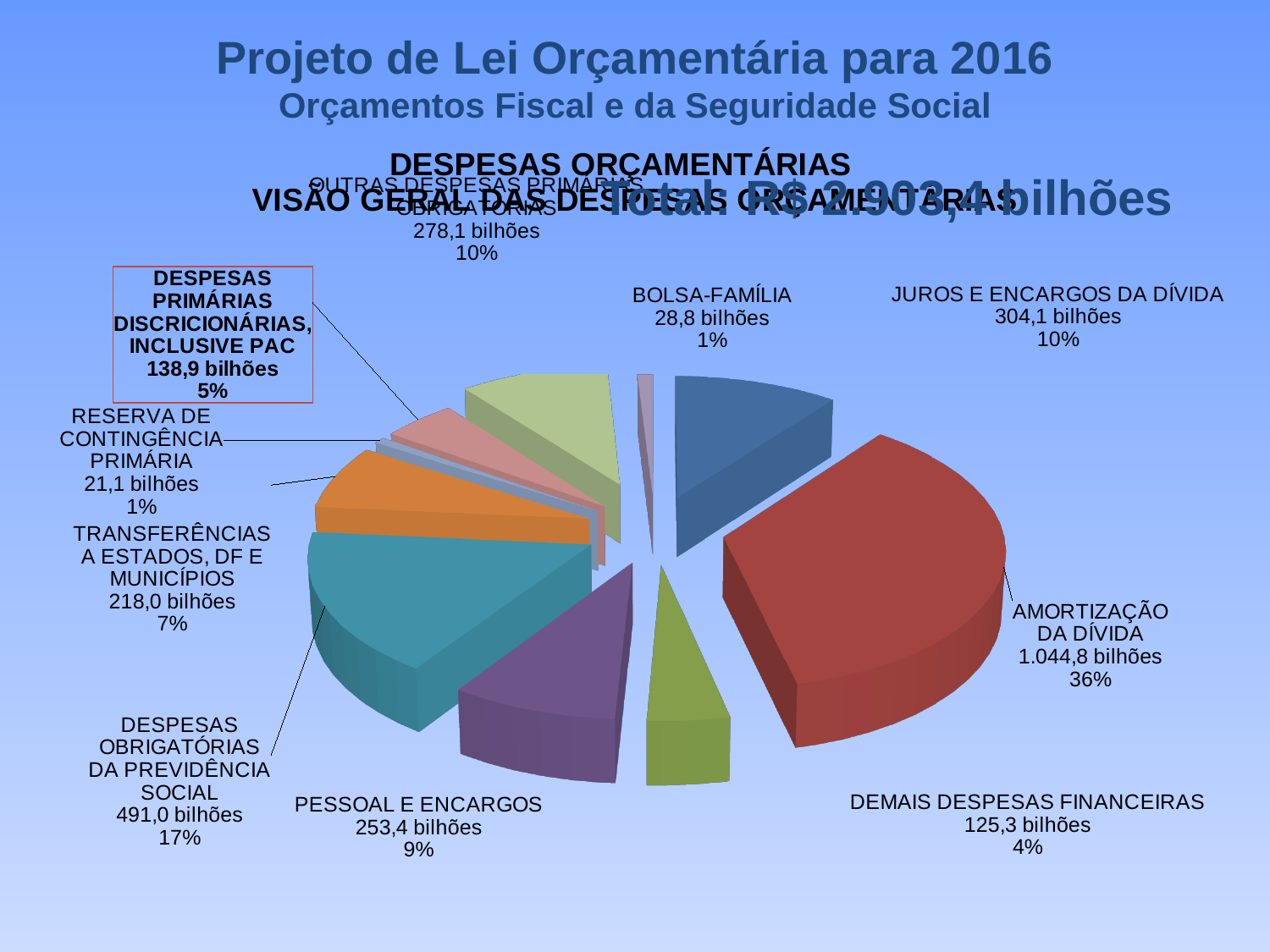
What kind of chart is shown on the slide? pie chart Which category has the largest slice of the pie? AMORTIZAÇÃO DA DÍVIDA How many slices does the pie chart have? 10 What share of the pie does JUROS E ENCARGOS DA DÍVIDA represent? 10% What is the value for AMORTIZAÇÃO DA DÍVIDA? 1.044,8 bilhões What is the main title at the top of the slide? Projeto de Lei Orçamentária para 2016 Which category has the smallest value in the pie? RESERVA DE CONTINGÊNCIA PRIMÁRIA What is the value for PESSOAL E ENCARGOS? 253,4 bilhões What is the value for DESPESAS OBRIGATÓRIAS DA PREVIDÊNCIA SOCIAL? 491,0 bilhões What is the difference between the values for JUROS E ENCARGOS DA DÍVIDA and PESSOAL E ENCARGOS? 50,7 bilhões Which is larger, DEMAIS DESPESAS FINANCEIRAS or DESPESAS PRIMÁRIAS DISCRICIONÁRIAS, INCLUSIVE PAC? DESPESAS PRIMÁRIAS DISCRICIONÁRIAS, INCLUSIVE PAC What share of the pie does TRANSFERÊNCIAS A ESTADOS, DF E MUNICÍPIOS represent? 7%